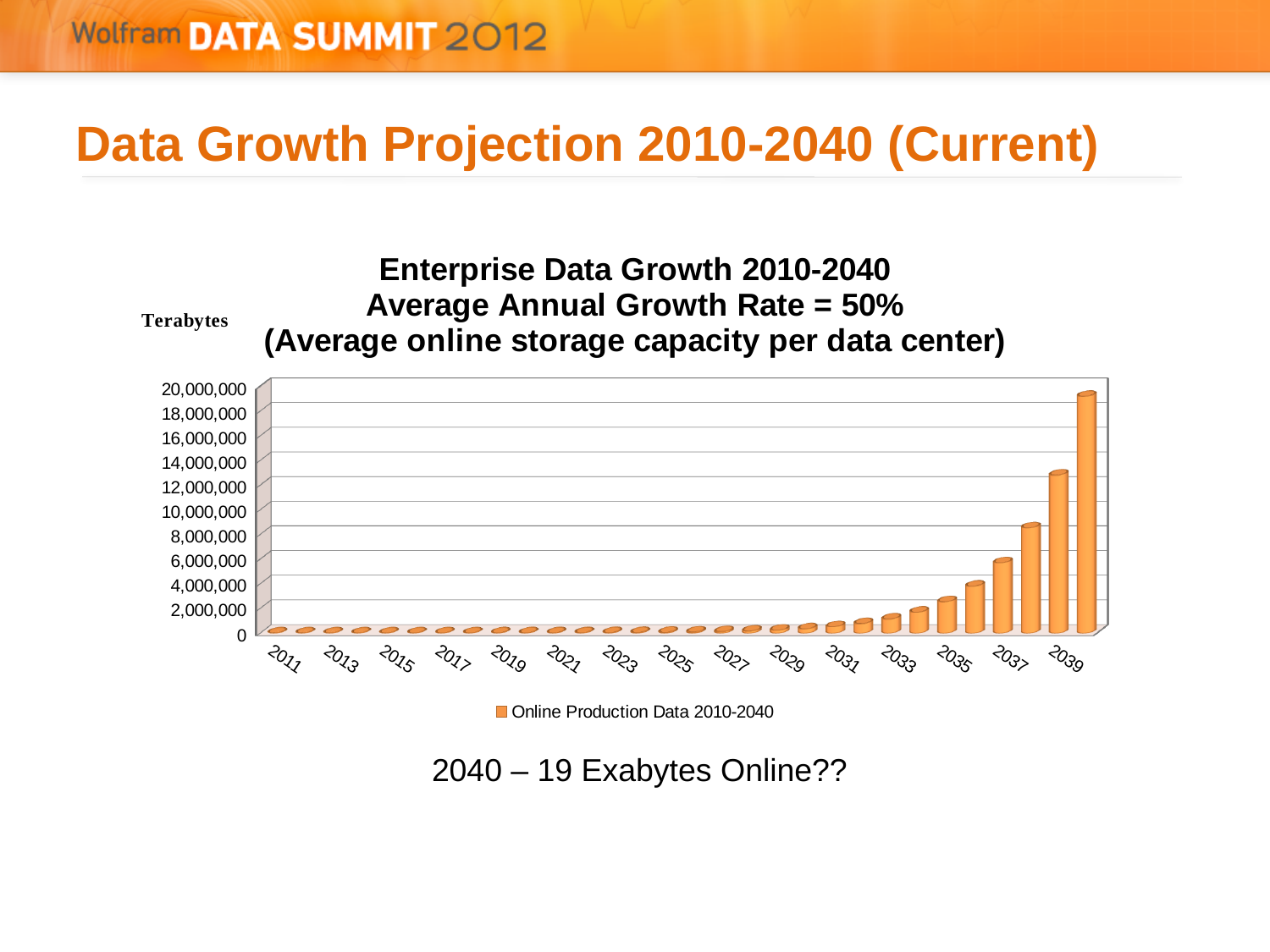
Do the values in the chart rise or fall as the years move from left to right? rise What is the name of the series shown in the chart legend? Online Production Data 2010-2040 Is the value for 2038 greater or less than 10,000,000? less Is the value for 2039 greater or less than 12,000,000? greater What unit is shown for the vertical axis of the chart? Terabytes Which is larger, the value for 2039 or the value for 2038? 2039 Is the value for 2037 greater or less than 4,000,000? greater What kind of chart is shown on the slide? bar chart How many series does the chart legend list? 1 Which year has the tallest bar in the chart? 2040